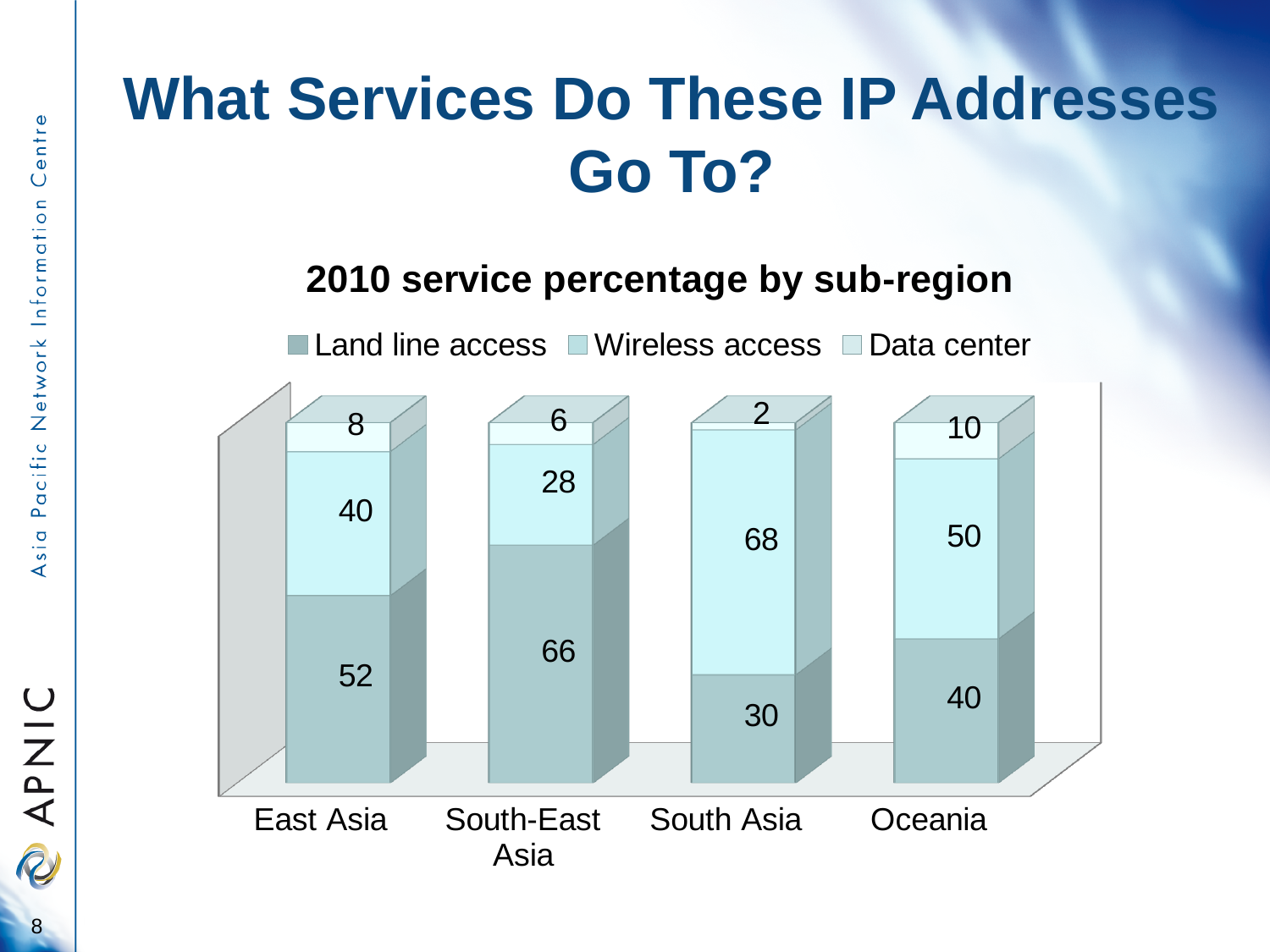
Which is larger: Land line access for East Asia or Land line access for South Asia? East Asia Which sub-region has the lowest Data center value? South Asia What is the Data center value for Oceania? 10 How many series does the legend list? 3 What is the total of the stacked bar for South-East Asia? 100 What is the title of the chart? 2010 service percentage by sub-region What is the difference between the Wireless access values for Oceania and South-East Asia? 22 What is the Wireless access value for South Asia? 68 What kind of chart is shown? Stacked bar chart What is the Land line access value for East Asia? 52 How many sub-regions are shown on the x axis? 4 Which sub-region has the highest Land line access value? South-East Asia